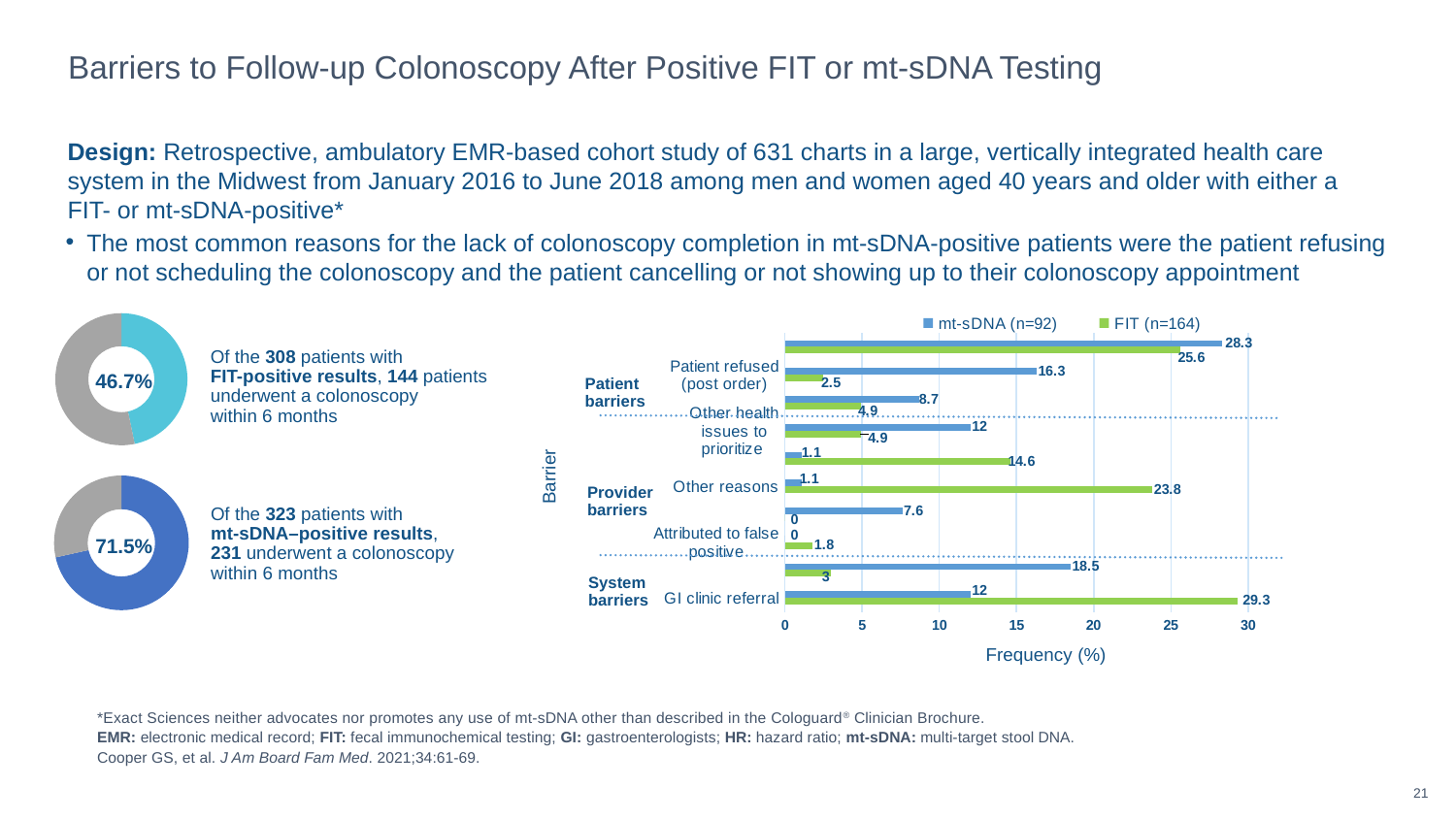
What is the highest value shown on the bar chart? 29.3 In the bar chart, what is the mt-sDNA value for Patient refused (post order)? 16.3 In the bar chart, what is the FIT value for GI clinic referral? 29.3 What percentage is shown in the top donut chart on the left of the slide? 46.7% What kind of chart is the chart on the right side of the slide? bar chart What is the label of the horizontal axis of the bar chart? Frequency (%) In the bar chart, what is the mt-sDNA value for GI clinic referral? 12 In the bar chart, for GI clinic referral, which series has the larger value, mt-sDNA or FIT? FIT In the bar chart, what is the difference between the FIT and mt-sDNA values for GI clinic referral? 17.3 How many series does the legend of the bar chart list? 2 What are the two series named in the legend of the bar chart? mt-sDNA (n=92) and FIT (n=164) What percentage is shown in the bottom donut chart on the left of the slide? 71.5%